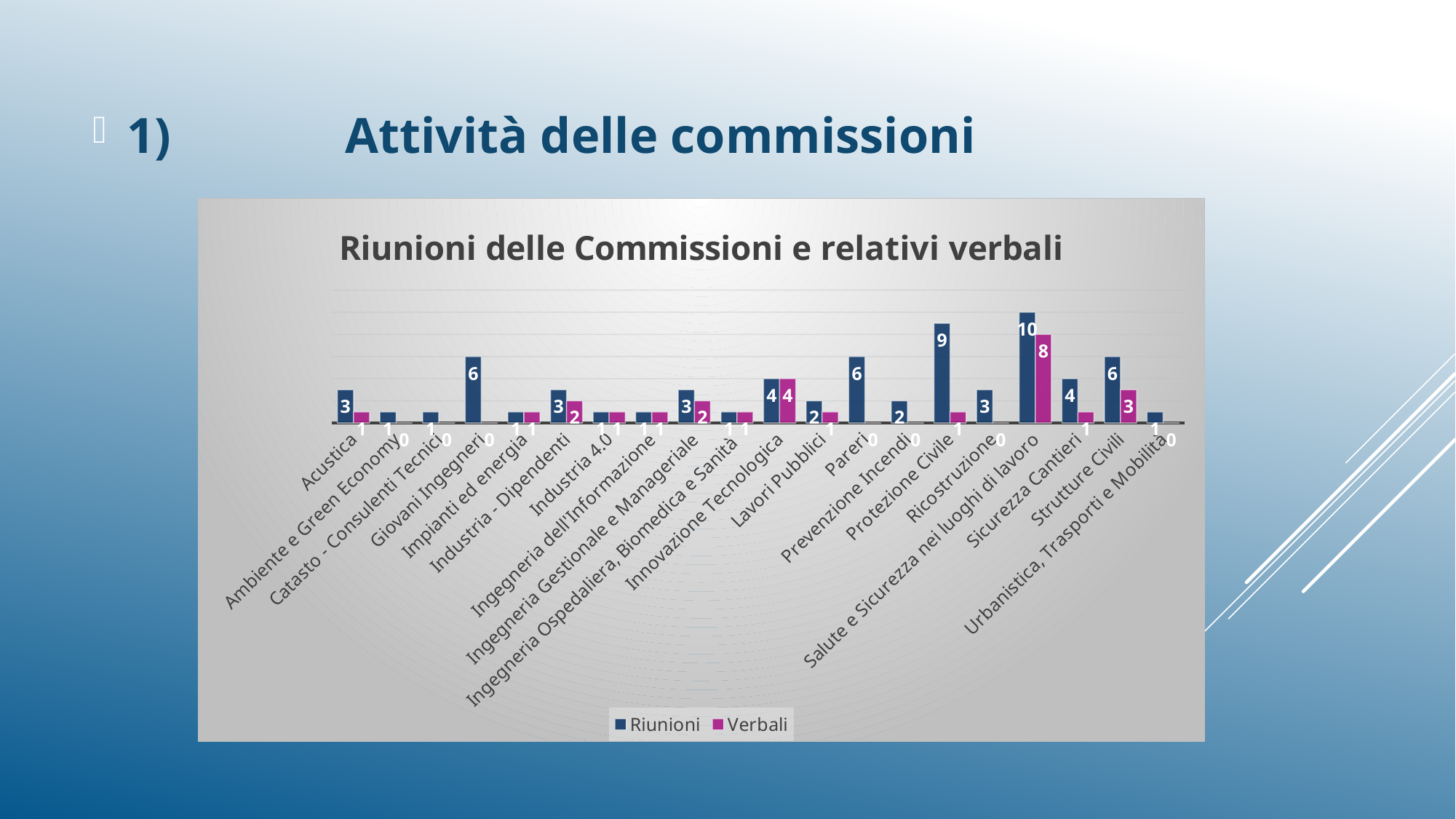
How many commissions (categories) are shown on the x axis? 20 What is the title of the chart? Riunioni delle Commissioni e relativi verbali Which is larger, the Riunioni value for Pareri or the Riunioni value for Sicurezza Cantieri? Pareri What is the difference between Riunioni and Verbali for Strutture Civili? 3 How many series does the legend list? 2 What is the difference between the Riunioni values for Protezione Civile and Giovani Ingegneri? 3 Which commission has the highest Riunioni value? Salute e Sicurezza nei luoghi di lavoro What is the Verbali value for Innovazione Tecnologica? 4 What is the Verbali value for Salute e Sicurezza nei luoghi di lavoro? 8 What is the Riunioni value for Ricostruzione? 3 What type of chart is shown on the slide? bar chart What is the Riunioni value for Protezione Civile? 9